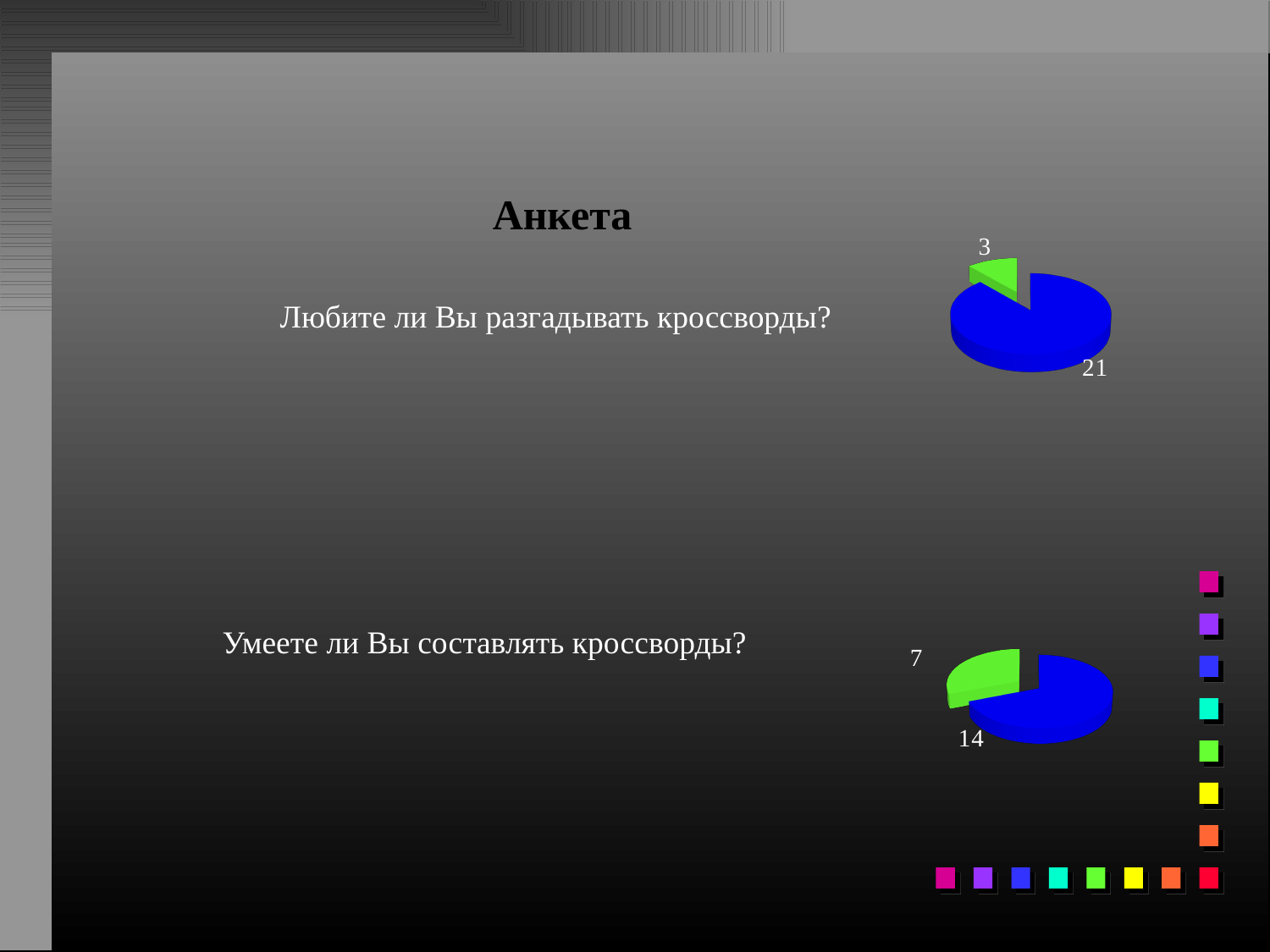
In the top pie chart, what is the difference between the two slice values? 18 In the top pie chart, what value is labelled on the blue slice? 21 What kind of chart is shown next to the question "Любите ли Вы разгадывать кроссворды?" at the top of the slide? pie chart In the top pie chart, what value is labelled on the green slice? 3 In the bottom pie chart, what share of the total does the green slice (7) represent? one third In the bottom pie chart, what value is labelled on the green slice? 7 What is the total of the two slice values in the bottom pie chart? 21 In the bottom pie chart, which slice is larger, the blue one or the green one? the blue one In the bottom pie chart (next to "Умеете ли Вы составлять кроссворды?"), what value is labelled on the blue slice? 14 How many slices does the top pie chart have? 2 What is the total of the two slice values in the top pie chart? 24 In the bottom pie chart, what is the difference between the blue slice and the green slice? 7